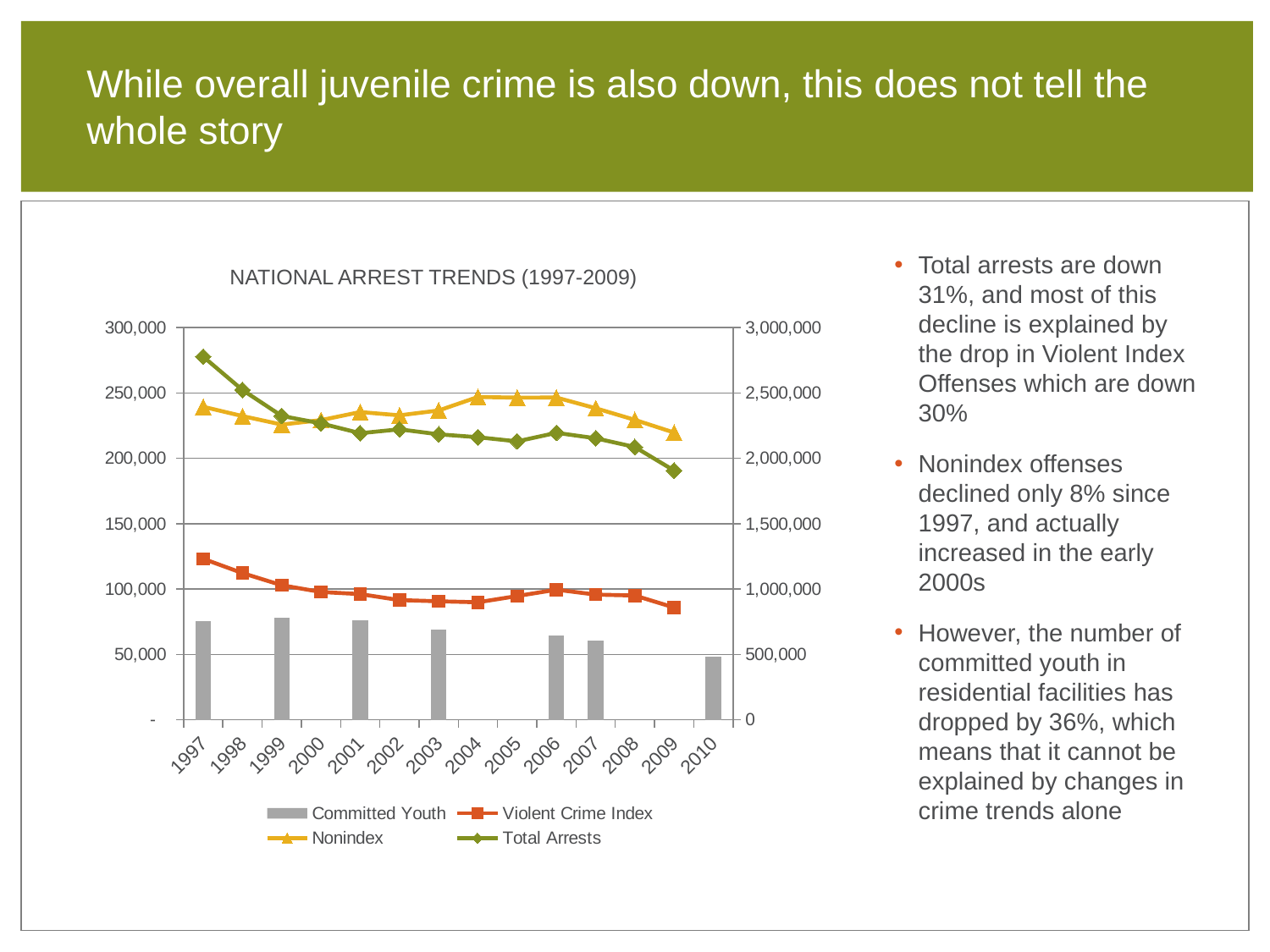
Which year has the lowest Committed Youth bar? 2010 In which year is the Total Arrests value highest? 1997 In which year is the Violent Crime Index value highest? 1997 On the left axis, is the Violent Crime Index value for 1997 greater or less than 100,000? greater What kind of chart is shown on the slide? A combined bar and line chart Which series is drawn as bars rather than a line? Committed Youth How many Committed Youth bars are plotted on the chart? 7 How many series does the legend of the NATIONAL ARREST TRENDS chart list? 4 How many years are shown along the x axis of the chart? 14 On the left axis, is the Committed Youth bar for 1997 greater or less than 50,000? greater Does the Total Arrests line rise or fall from 1997 to 2009? Falls In which year is the Total Arrests value lowest? 2009